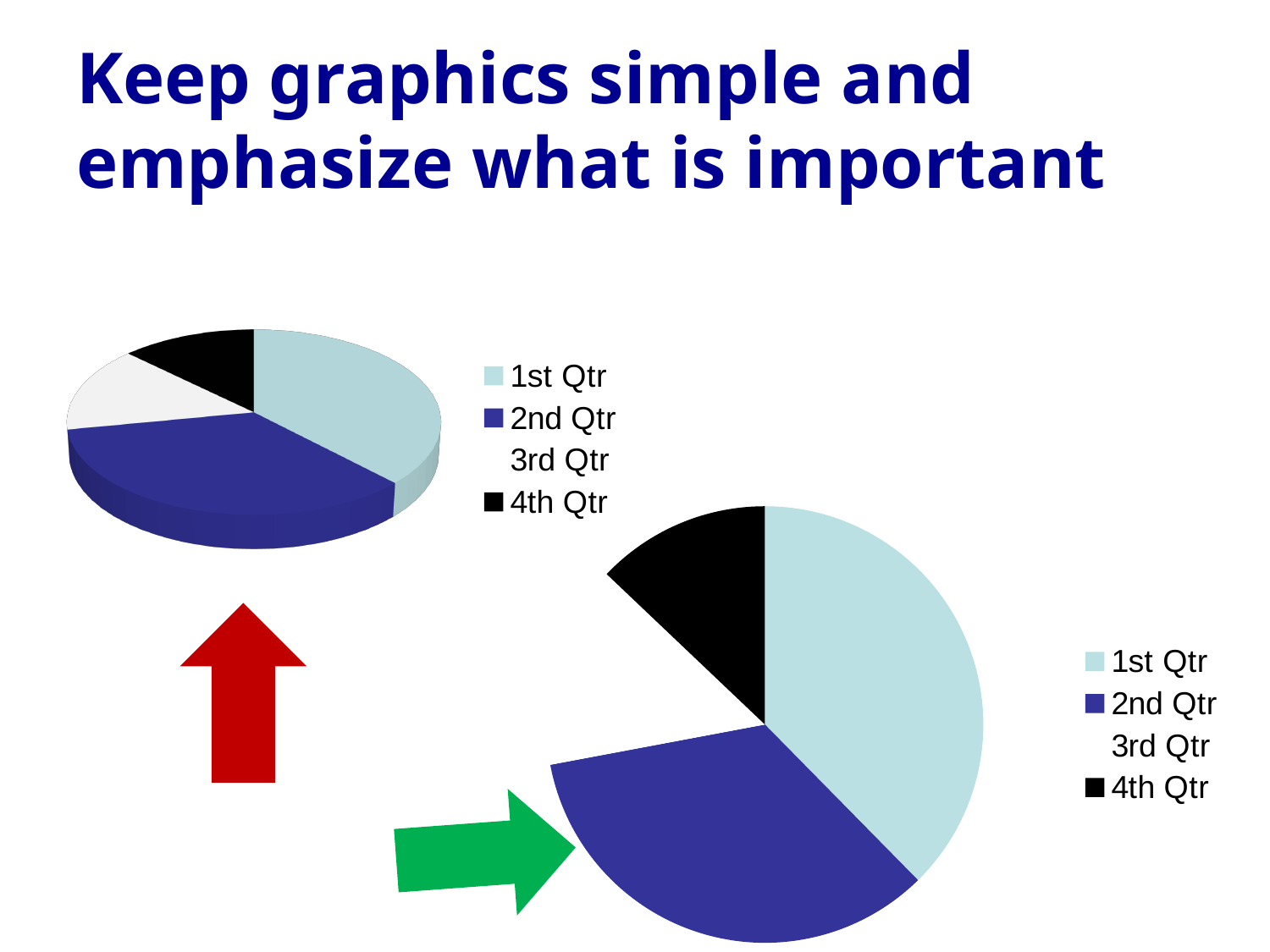
What is the first category listed in the legend of the bottom-right pie chart? 1st Qtr What kind of chart is the chart at the bottom right of the slide? pie chart In the bottom-right pie chart, which is larger, the 2nd Qtr slice or the 4th Qtr slice? 2nd Qtr How many pie charts are shown on the slide? 2 How many categories does the legend of the bottom-right pie chart list? 4 How many categories does the legend of the top-left pie chart list? 4 In the top-left pie chart, which is larger, the 2nd Qtr slice or the 4th Qtr slice? 2nd Qtr What kind of chart is the chart at the top left of the slide? pie chart In the bottom-right pie chart, which is larger, the 1st Qtr slice or the 4th Qtr slice? 1st Qtr In the bottom-right pie chart, what colour is the 4th Qtr slice? black